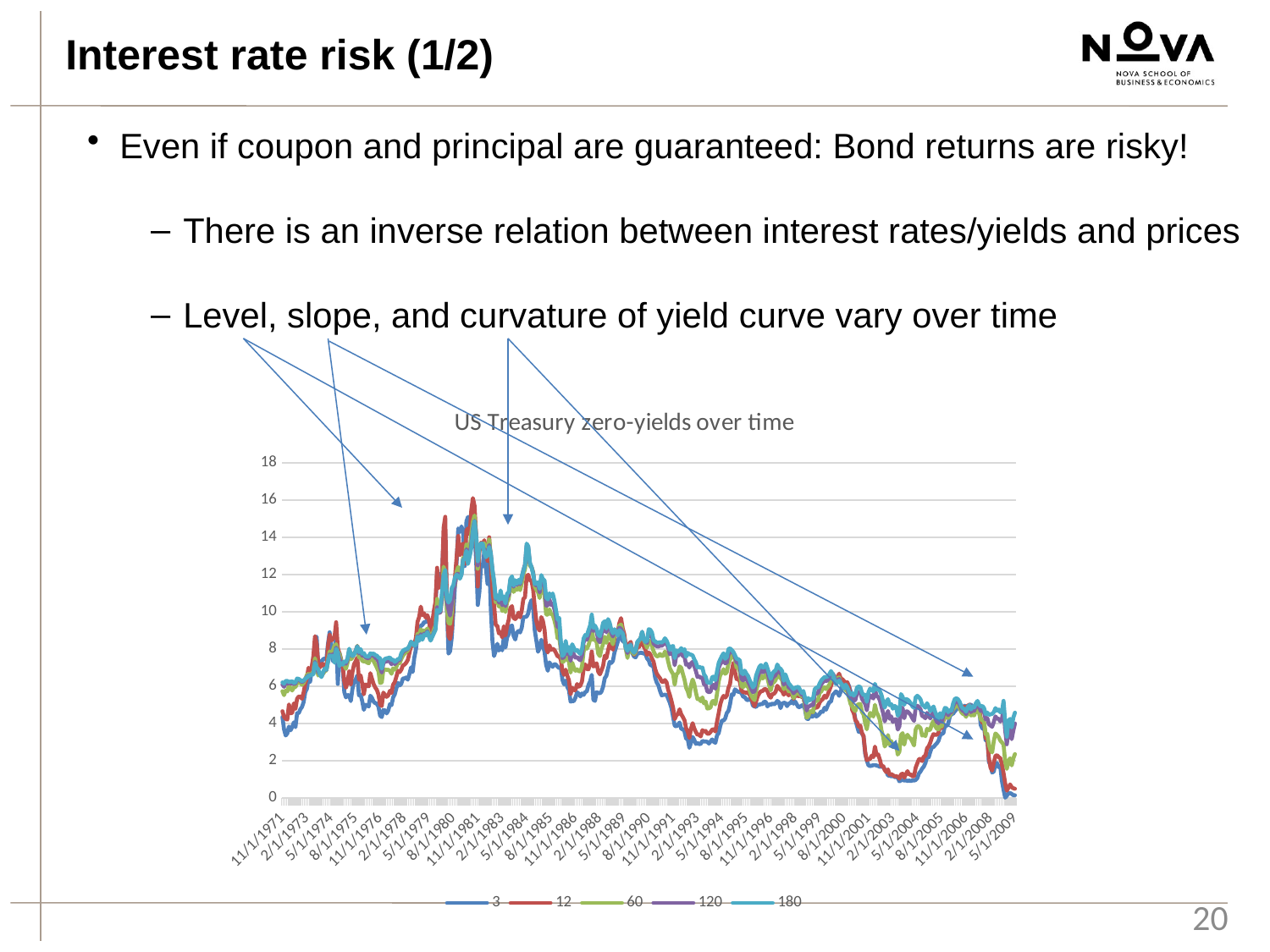
What is the highest tick value shown on the chart's vertical axis? 18 What kind of chart is shown on the slide? line chart Is the value of the 180 series at 11/1/1971 greater or less than 8? less How many series does the chart legend list? 5 What is the first date label on the chart's horizontal axis? 11/1/1971 What is the title of the chart? US Treasury zero-yields over time What are the series names listed in the chart legend? 3, 12, 60, 120, 180 What is the last date label on the chart's horizontal axis? 5/1/2009 Is the peak value of the 12 series around 1981 greater or less than 14? greater From the peak around 1981 to 5/1/2009, do the yields in the chart generally rise or fall? fall Is the value of the 3 series at 5/1/2009 greater or less than 2? less